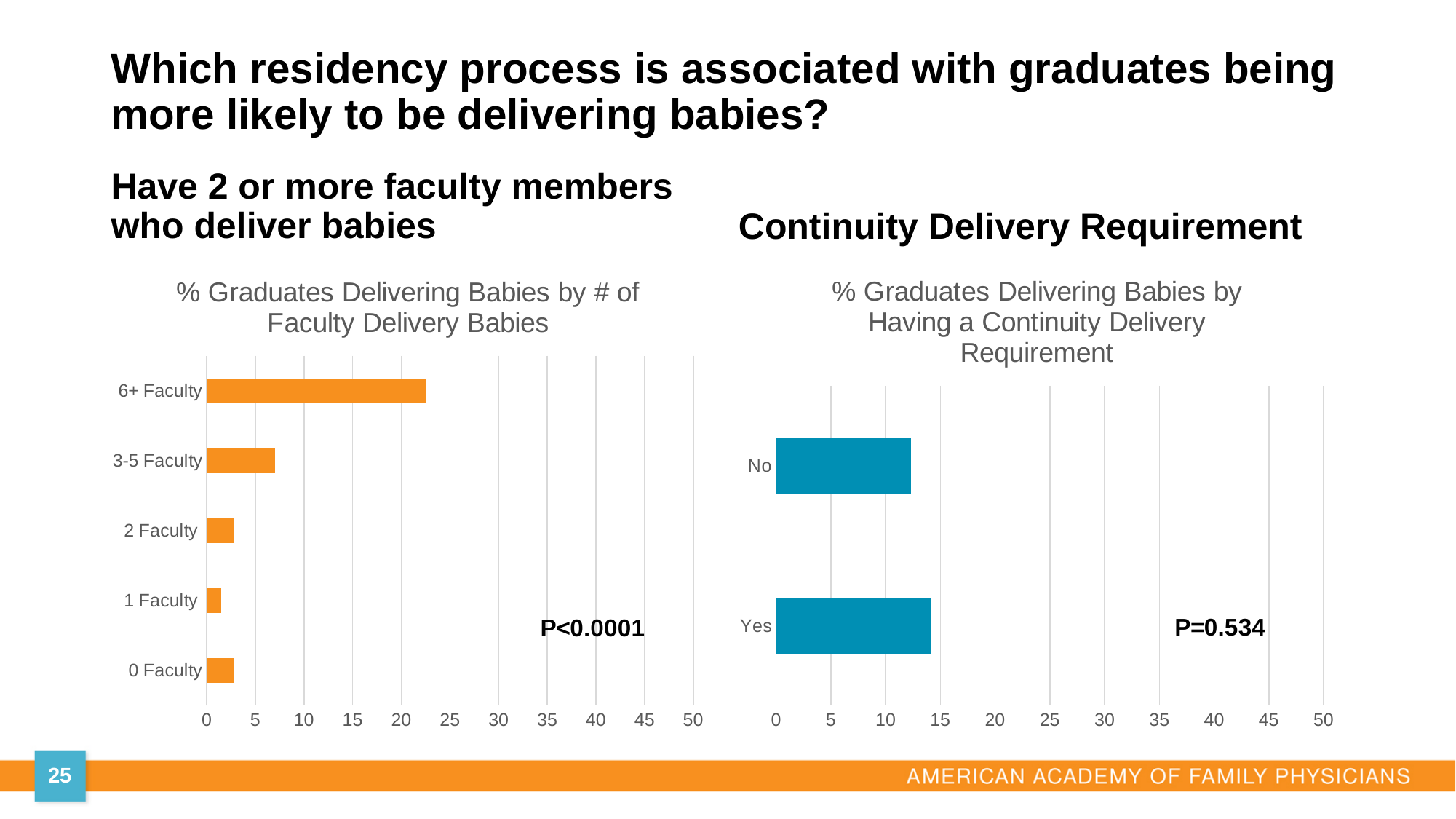
What P-value is printed on the right chart, '% Graduates Delivering Babies by Having a Continuity Delivery Requirement'? P=0.534 In the left chart, '% Graduates Delivering Babies by # of Faculty Delivery Babies', is the value for 3-5 Faculty greater or less than 10? less In the left chart, '% Graduates Delivering Babies by # of Faculty Delivery Babies', is the value for 6+ Faculty greater or less than 20? greater What P-value is printed on the left chart, '% Graduates Delivering Babies by # of Faculty Delivery Babies'? P<0.0001 In the left chart, '% Graduates Delivering Babies by # of Faculty Delivery Babies', which is larger: the value for 6+ Faculty or the value for 3-5 Faculty? 6+ Faculty How many categories are shown in the left chart, '% Graduates Delivering Babies by # of Faculty Delivery Babies'? 5 In the left chart, '% Graduates Delivering Babies by # of Faculty Delivery Babies', which category has the lowest value? 1 Faculty In the right chart, '% Graduates Delivering Babies by Having a Continuity Delivery Requirement', which category has the higher value? Yes What kind of chart is the left chart, '% Graduates Delivering Babies by # of Faculty Delivery Babies'? bar chart How many categories are shown in the right chart, '% Graduates Delivering Babies by Having a Continuity Delivery Requirement'? 2 In the left chart, '% Graduates Delivering Babies by # of Faculty Delivery Babies', which category has the highest value? 6+ Faculty In the right chart, '% Graduates Delivering Babies by Having a Continuity Delivery Requirement', is the value for No greater or less than 10? greater